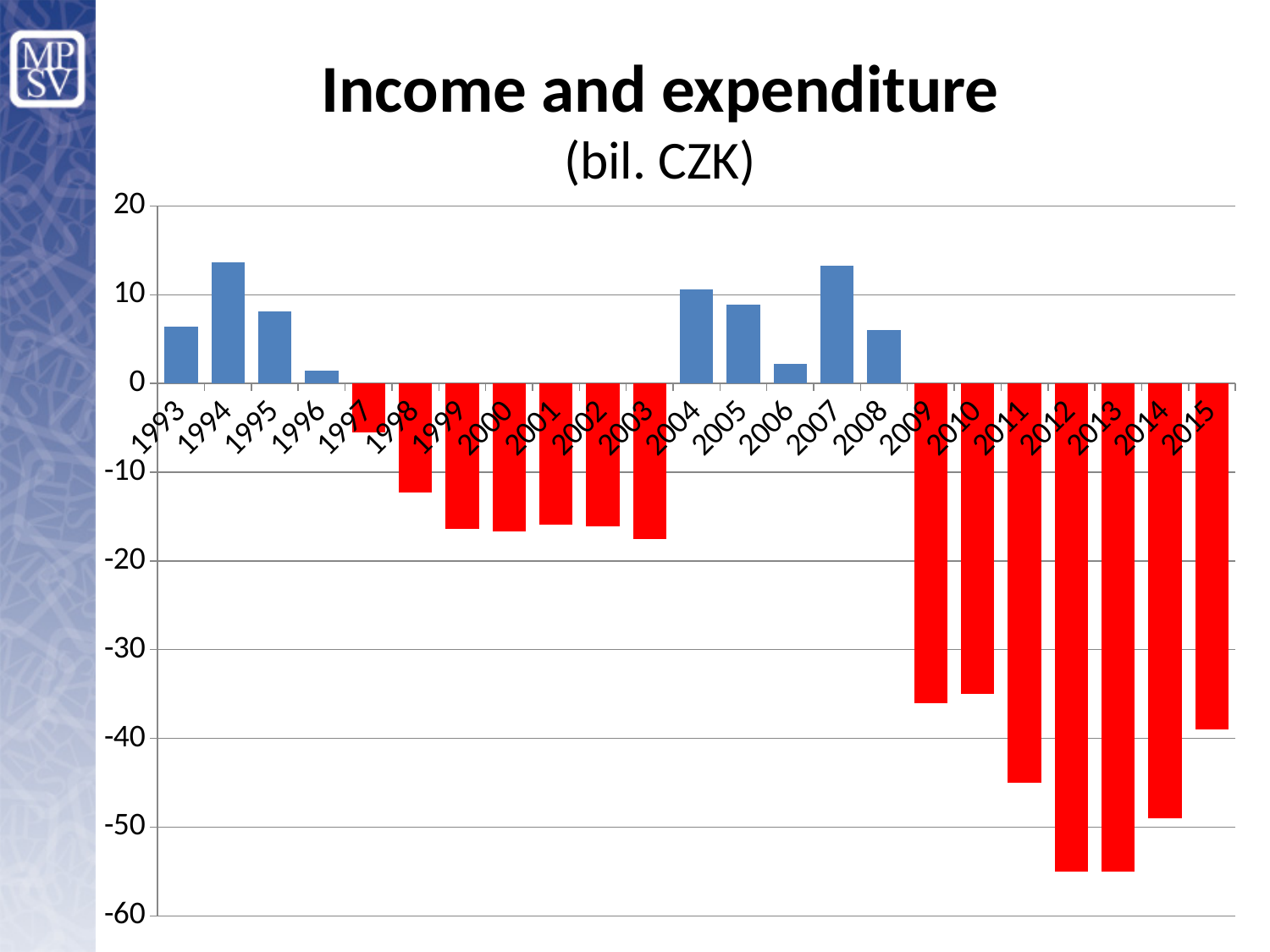
Is the value for 2015 greater or less than -30? less How many years are shown on the x axis of the chart? 23 Is the value for 1994 greater or less than 10? greater Is the value for 2009 greater or less than -40? greater What is the title of the chart? Income and expenditure (bil. CZK) Which is larger, the value for 1994 or the value for 1995? 1994 Do the values rise or fall from 2009 to 2012? fall What kind of chart is shown on the slide? bar chart What colour are the bars with negative values? red Which is larger, the value for 2010 or the value for 2011? 2010